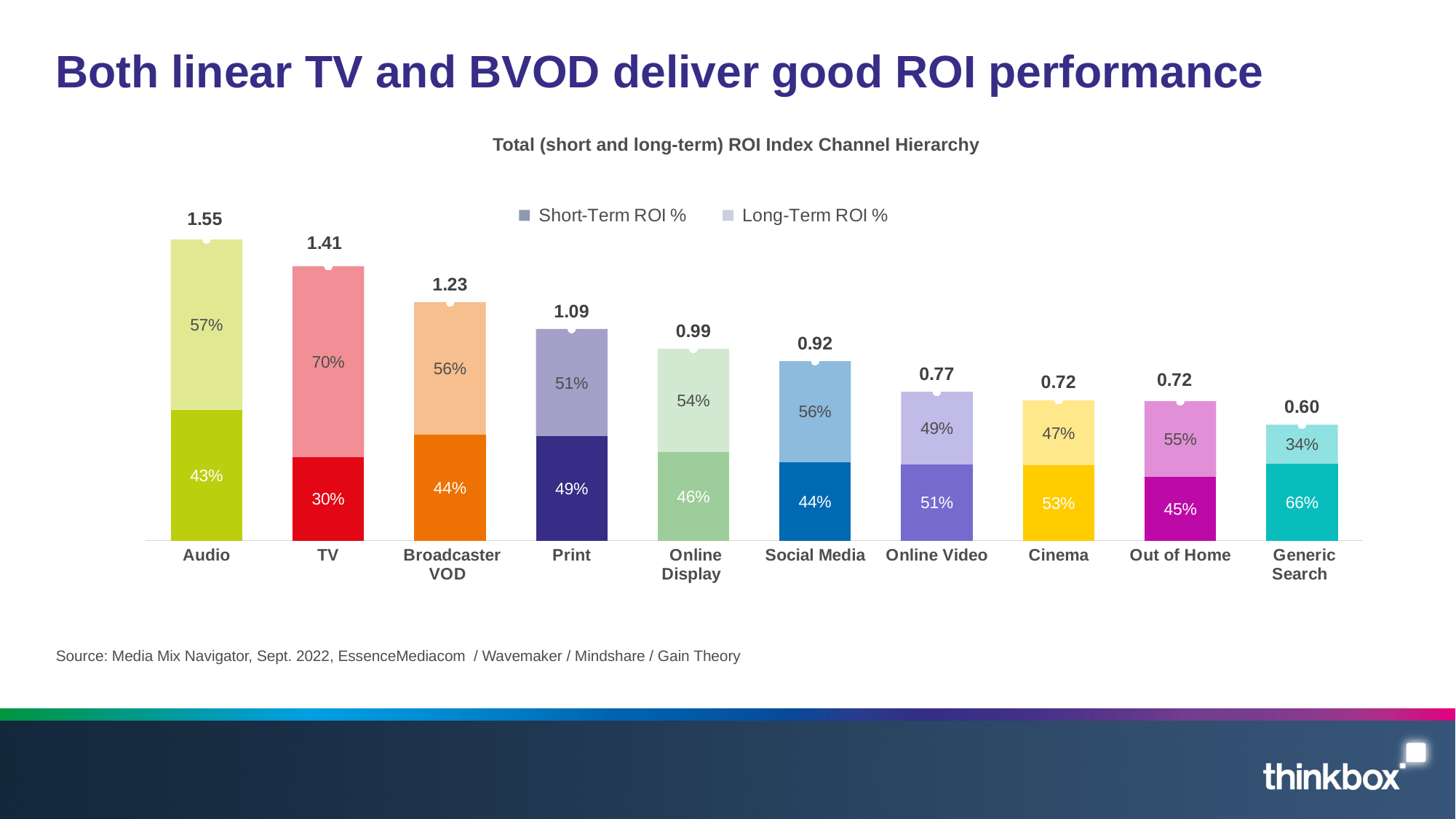
What kind of chart is shown on the slide? Stacked bar chart Which channel has the lowest total ROI index? Generic Search What is the total ROI index shown above the Audio bar? 1.55 How many series does the legend list? 2 What Short-Term ROI % is shown for TV? 30% Which channel has the highest total ROI index? Audio What is the title of the chart? Total (short and long-term) ROI Index Channel Hierarchy How many channels are shown on the x axis? 10 What is the difference between the total ROI index for Audio and for Generic Search? 0.95 What Long-Term ROI % is shown for Broadcaster VOD? 56% Which has a higher total ROI index, TV or Print? TV What is the total ROI index shown above the Social Media bar? 0.92